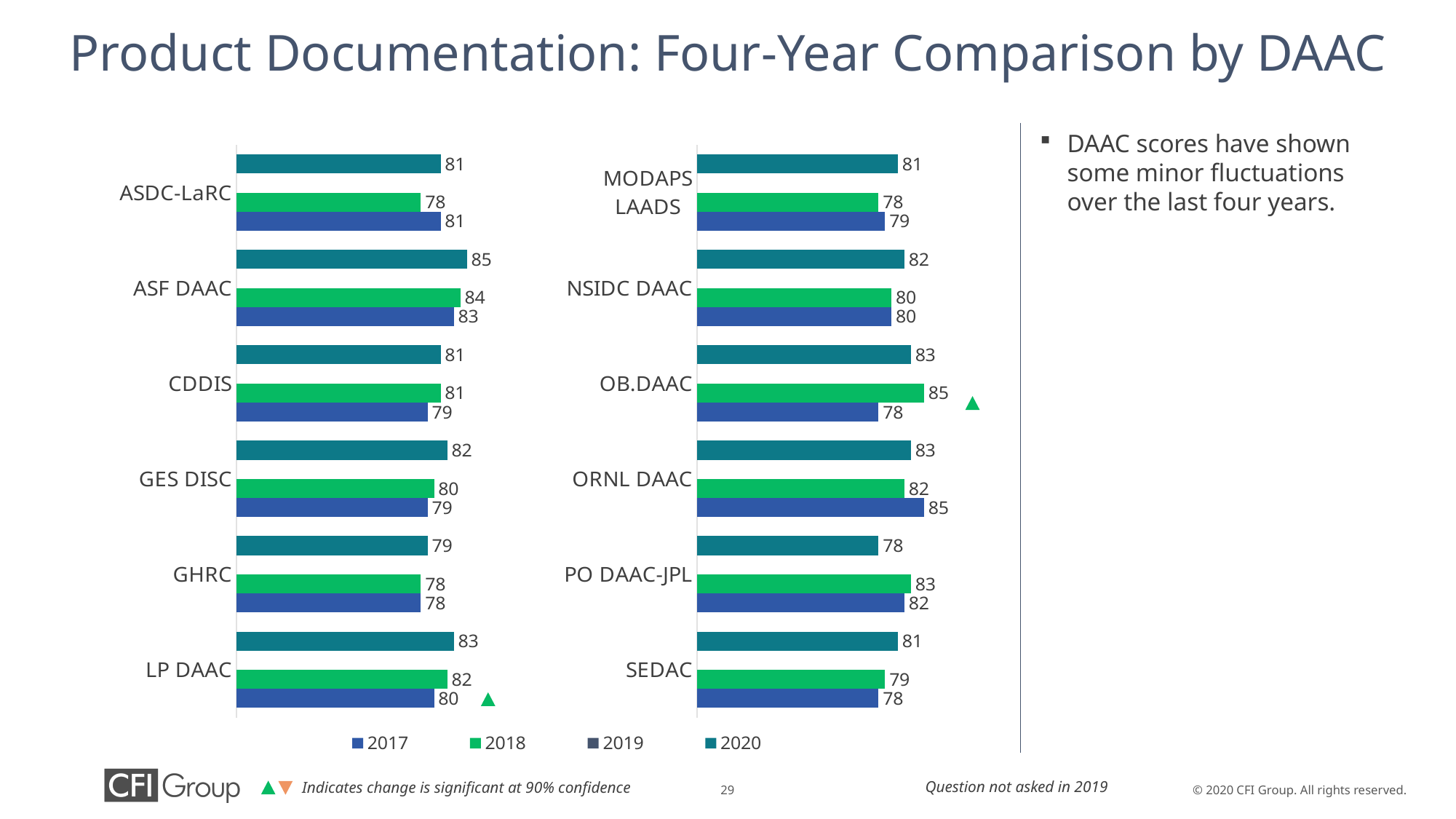
In the left chart, do the values for ASF DAAC rise or fall from 2017 to 2020? Rise How many DAACs are shown in the left chart? 6 In the right chart, what is the 2018 value for OB.DAAC? 85 In the left chart, what is the 2020 value for ASF DAAC? 85 What type of chart is used on this slide? Bar chart Which year is noted as not having the question asked? 2019 How many series does the legend list? 4 In the right chart, which DAAC has the lowest 2020 value? PO DAAC-JPL In the left chart, what is the 2017 value for LP DAAC? 80 In the right chart, which is larger for PO DAAC-JPL: the 2018 value or the 2020 value? 2018 In the left chart, what is the difference between the 2020 and 2017 values for LP DAAC? 3 In the right chart, which DAAC has the highest 2017 value? ORNL DAAC